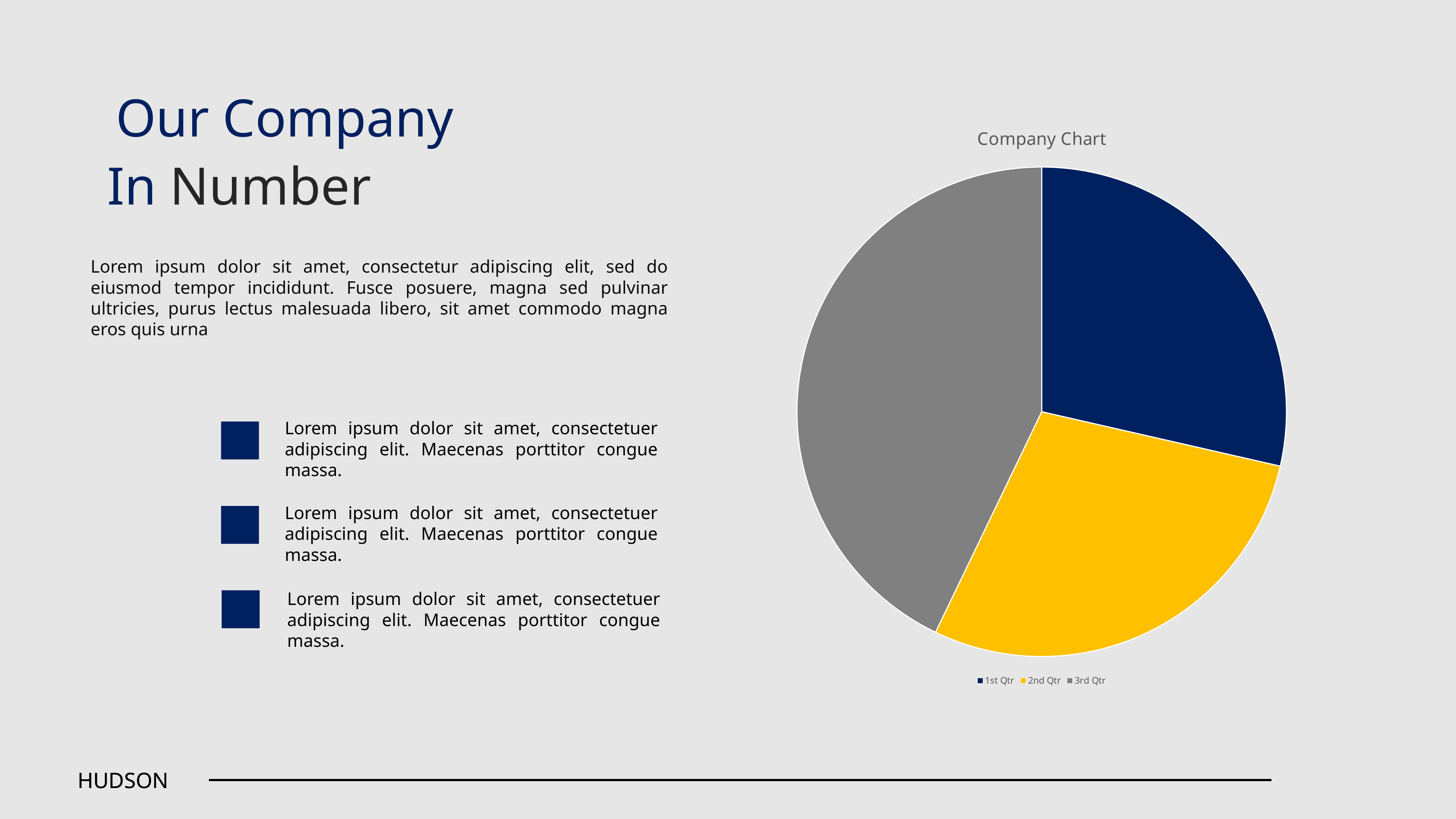
How many entries does the chart legend list? 3 What is the title of the chart? Company Chart Which category has the largest slice of the pie? 3rd Qtr Which colour represents 2nd Qtr in the pie chart? yellow What kind of chart is shown on the slide? pie chart Which slice is larger, 3rd Qtr or 1st Qtr? 3rd Qtr How many slices does the pie chart have? 3 Which slice is larger, 2nd Qtr or 3rd Qtr? 3rd Qtr